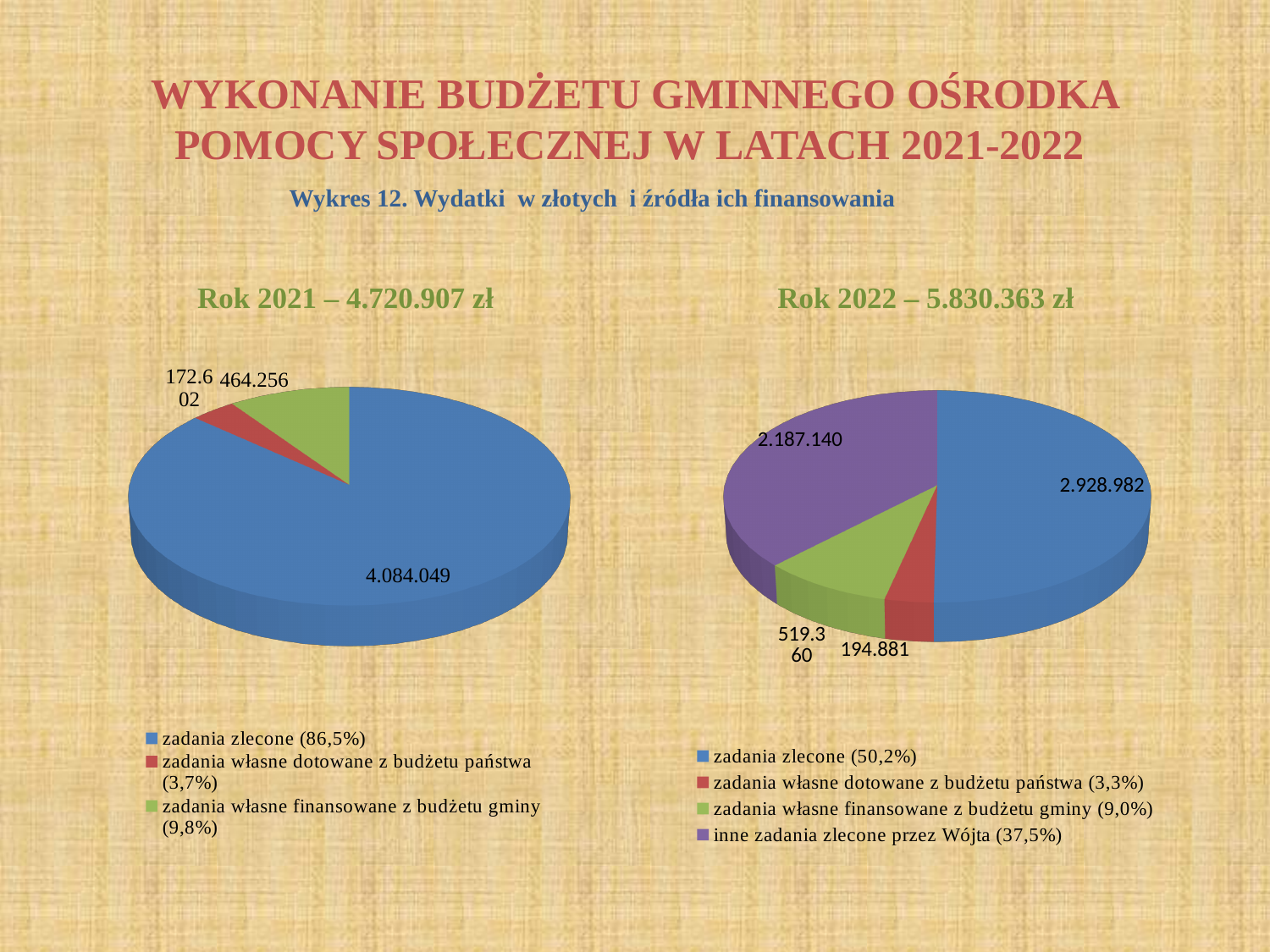
In the Rok 2022 pie chart, what is the value for inne zadania zlecone przez Wójta? 2.187.140 In the Rok 2022 pie chart, which category has the largest value? zadania zlecone What is the total shown in the heading for the Rok 2022 chart? 5.830.363 zł In the Rok 2022 pie chart, what is the value for zadania własne dotowane z budżetu państwa? 194.881 In the Rok 2021 pie chart, what is the value for zadania własne finansowane z budżetu gminy? 464.256 How many slices does the Rok 2022 pie chart have? 4 In the Rok 2021 pie chart, which category has the smallest value? zadania własne dotowane z budżetu państwa In the Rok 2021 pie chart, what is the value for zadania zlecone? 4.084.049 In the Rok 2022 pie chart, what is the difference between zadania zlecone and inne zadania zlecone przez Wójta? 741.842 What type of chart is used for Rok 2021? pie chart In the Rok 2022 pie chart, which is larger: zadania własne finansowane z budżetu gminy or zadania własne dotowane z budżetu państwa? zadania własne finansowane z budżetu gminy In the Rok 2021 pie chart, what share of the pie does zadania zlecone represent? 86,5%